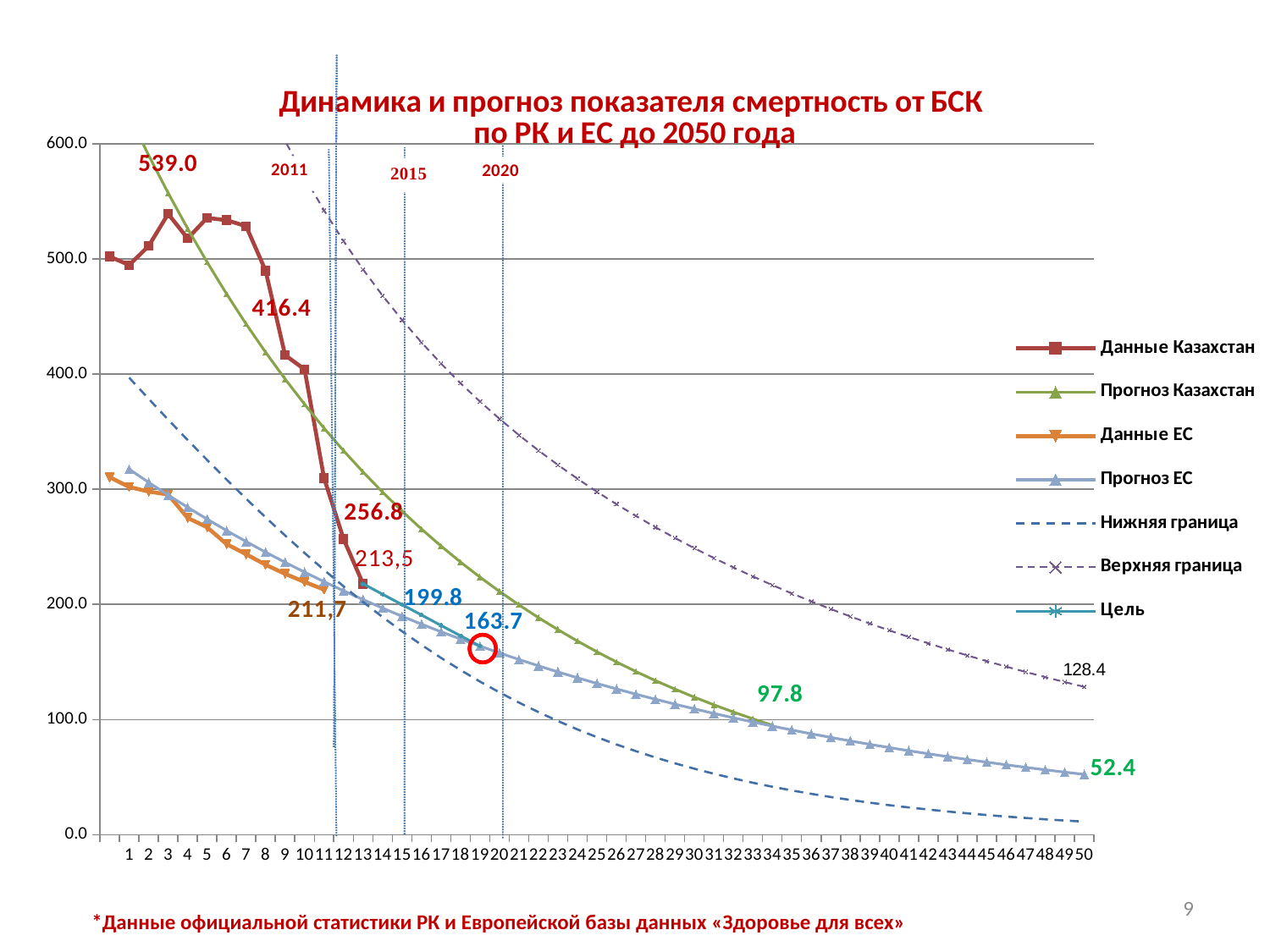
What is the highest value labelled on the Данные Казахстан series? 539.0 Does the Прогноз ЕС series rise or fall along the x axis? fall What value is labelled at the end of the Прогноз ЕС series at point 50? 52.4 What value is marked with the red circle on the chart? 163.7 At point 50, which is larger: the Прогноз ЕС value or the Верхняя граница value? Верхняя граница What is the difference between the labelled values 539.0 and 416.4 on the Данные Казахстан series? 122.6 What is the difference between the labelled end values of Верхняя граница (128.4) and Прогноз ЕС (52.4)? 76.0 What value is labelled at the end of the Верхняя граница series? 128.4 What kind of chart is shown on the slide? line chart Is the value of Данные Казахстан at point 1 greater or less than 400? greater What is the last labelled value of the Данные ЕС series? 211,7 How many series does the legend list? 7